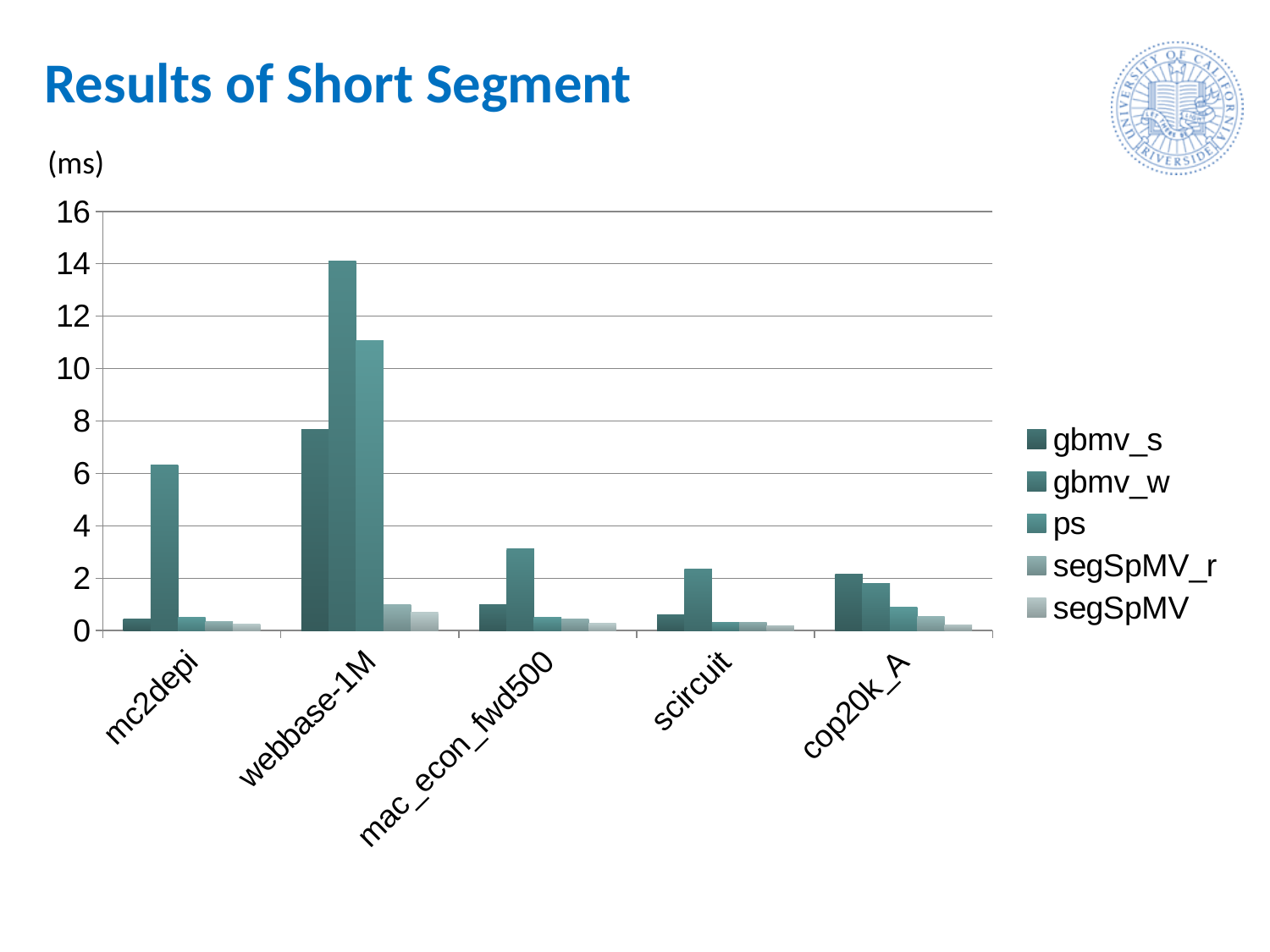
Is the gbmv_w value for mac_econ_fwd500 greater or less than 2? greater What unit is shown for the y axis? ms Which category has the highest gbmv_w value? webbase-1M Is the gbmv_s value for webbase-1M greater or less than 6? greater What kind of chart is shown on the slide? bar chart Is the gbmv_w value for webbase-1M greater or less than 12? greater For webbase-1M, which is larger: gbmv_w or ps? gbmv_w How many series does the legend list? 5 Which series has the lowest value for webbase-1M? segSpMV How many categories (matrices) are shown on the x axis? 5